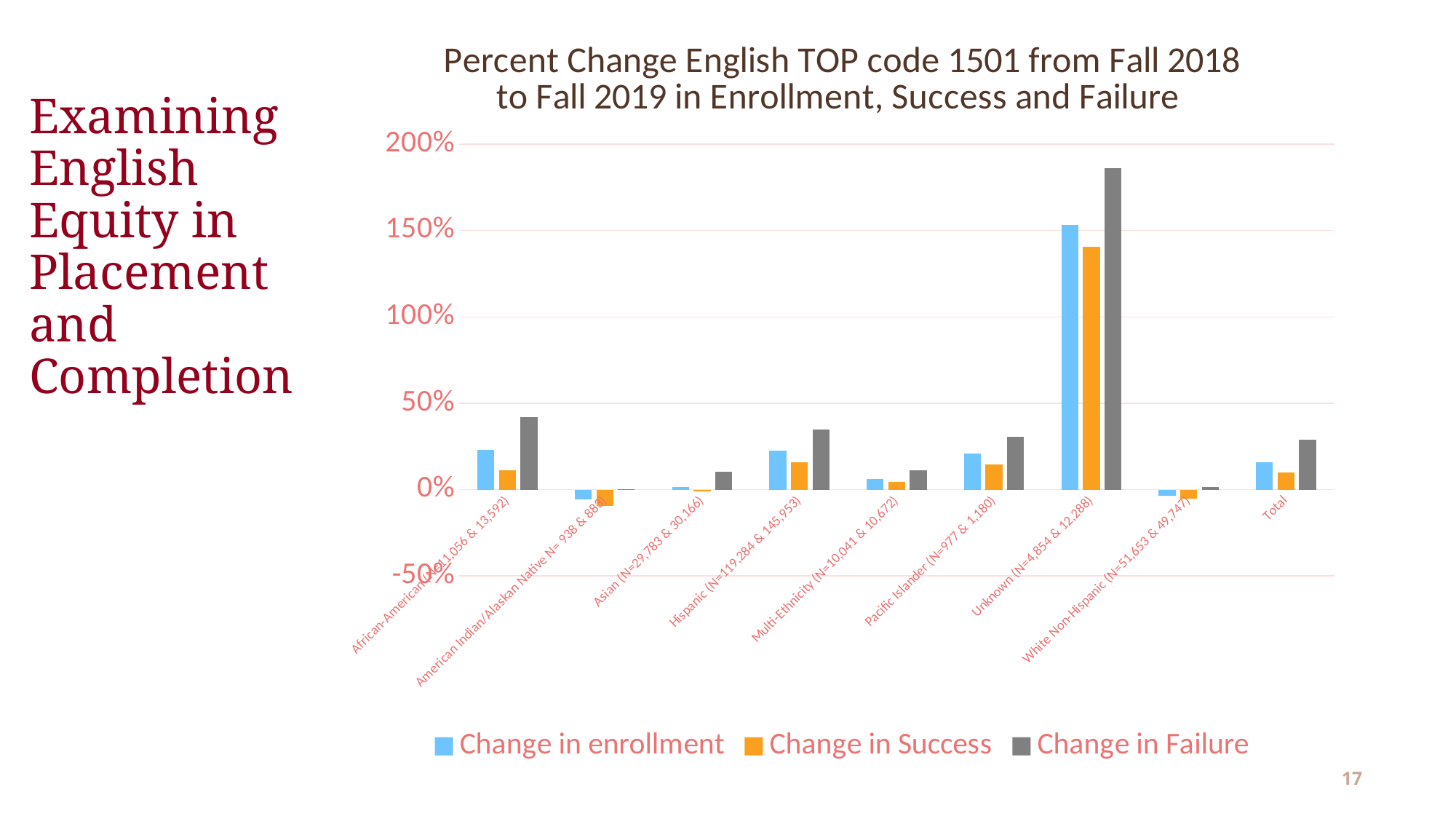
What is the title of the chart? Percent Change English TOP code 1501 from Fall 2018 to Fall 2019 in Enrollment, Success and Failure Is the Change in Failure for Unknown greater or less than 150%? greater How many series does the legend list? 3 What kind of chart is shown on the slide? bar chart How many categories are shown along the x axis? 9 Is the Change in Success for Unknown greater or less than 150%? less For Total, which is larger: Change in Failure or Change in Success? Change in Failure Which category has the highest Change in Failure? Unknown Which category has the highest Change in enrollment? Unknown Which series is shown in orange? Change in Success Is the Change in Failure for Hispanic greater or less than 50%? less For Unknown, which is larger: Change in Failure or Change in Success? Change in Failure